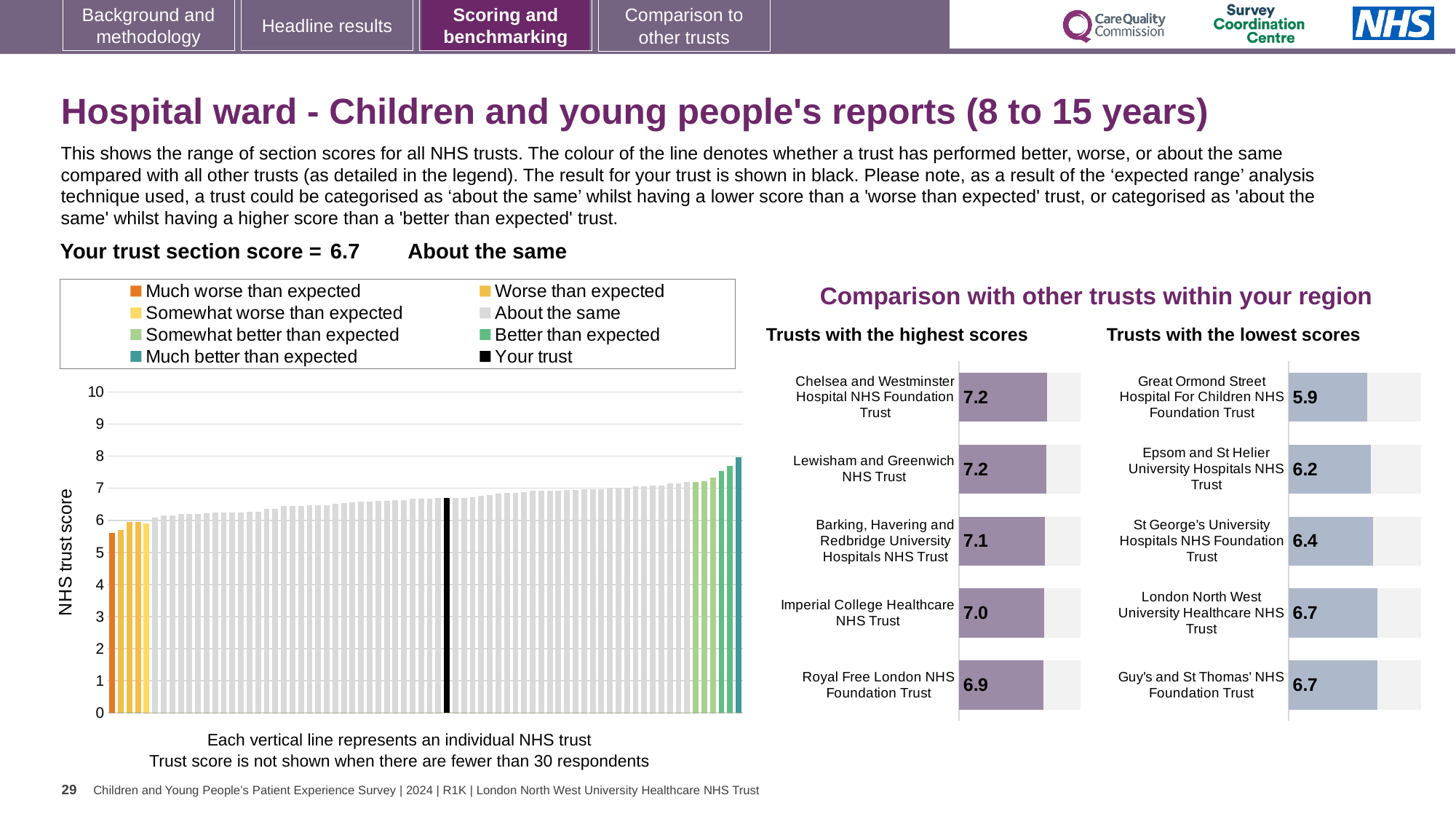
In the 'Trusts with the highest scores' chart, what is the score for Royal Free London NHS Foundation Trust? 6.9 In the 'Trusts with the lowest scores' chart, what is the score for St George's University Hospitals NHS Foundation Trust? 6.4 In the 'Trusts with the lowest scores' chart, which has the larger score: Epsom and St Helier University Hospitals NHS Trust or London North West University Healthcare NHS Trust? London North West University Healthcare NHS Trust How many trusts are listed in the 'Trusts with the highest scores' chart? 5 What kind of chart is the large chart on the left showing all NHS trusts? bar chart In the 'Trusts with the lowest scores' chart, what is the score for Great Ormond Street Hospital For Children NHS Foundation Trust? 5.9 In the 'Trusts with the lowest scores' chart, what is the difference between the score for Guy's and St Thomas' NHS Foundation Trust and the score for Great Ormond Street Hospital For Children NHS Foundation Trust? 0.8 In the 'Trusts with the lowest scores' chart, which trust has the lowest score? Great Ormond Street Hospital For Children NHS Foundation Trust In the 'Trusts with the highest scores' chart, what is the score for Imperial College Healthcare NHS Trust? 7.0 In the 'Trusts with the highest scores' chart, what is the difference between the score for Chelsea and Westminster Hospital NHS Foundation Trust and the score for Royal Free London NHS Foundation Trust? 0.3 In the large chart on the left showing all NHS trusts, is the value of the tallest bar greater or less than 7? greater In the large chart on the left showing all NHS trusts, is the value of the black bar (your trust) greater or less than 7? less